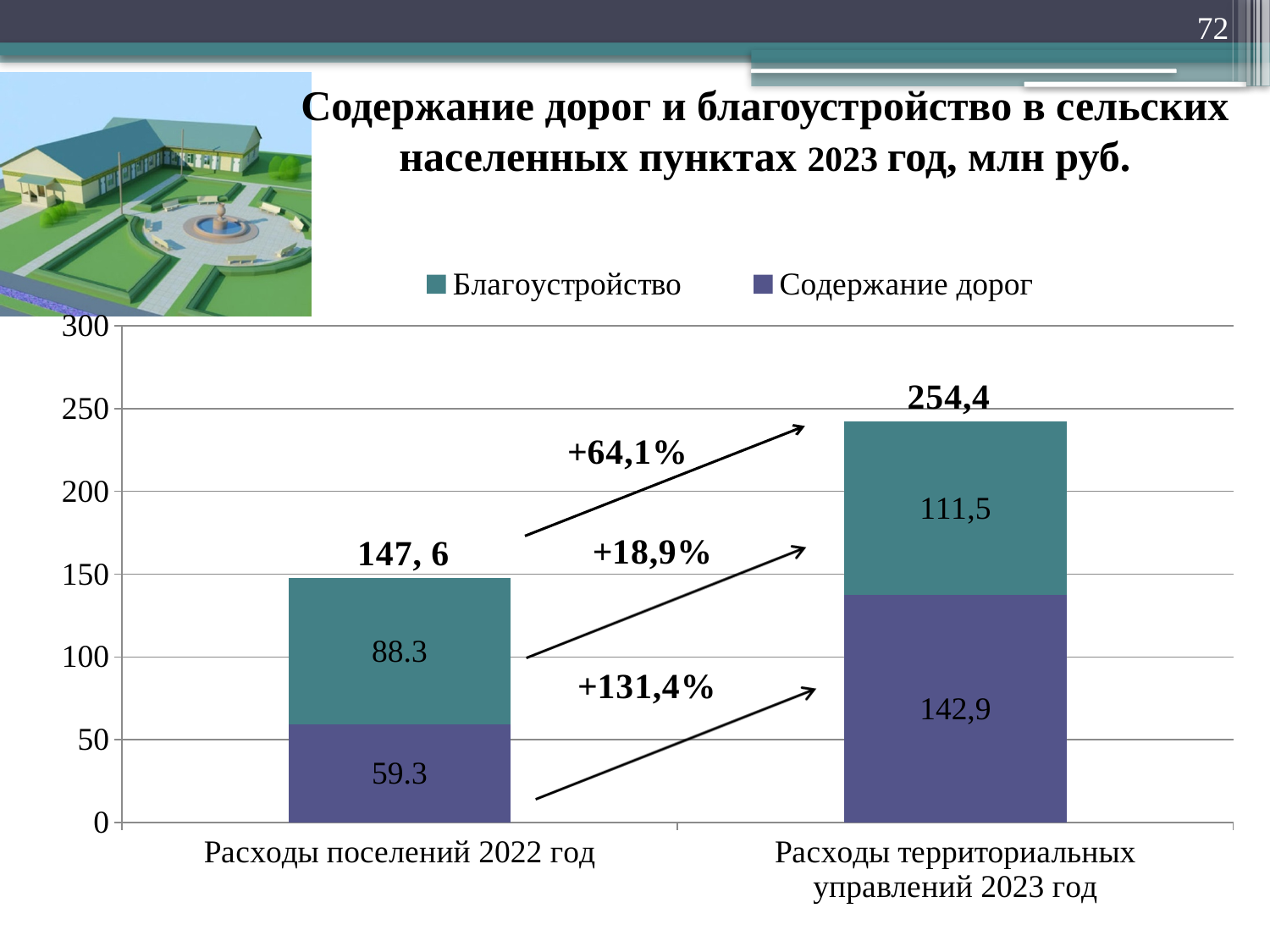
What is the value of Благоустройство for Расходы территориальных управлений 2023 год? 111,5 How many categories are shown on the x axis? 2 Which is larger for Расходы территориальных управлений 2023 год: Содержание дорог or Благоустройство? Содержание дорог What is the total of the stacked bar for Расходы территориальных управлений 2023 год? 254,4 Is the value of Содержание дорог for Расходы территориальных управлений 2023 год greater or less than 100? greater What type of chart is shown on the slide? stacked bar chart Which category has the higher total stacked bar? Расходы территориальных управлений 2023 год What is the difference between Содержание дорог and Благоустройство for Расходы территориальных управлений 2023 год? 31,4 How many series does the legend list? 2 What is the value of Содержание дорог for Расходы поселений 2022 год? 59.3 What is the value of Благоустройство for Расходы поселений 2022 год? 88.3 What is the value of Содержание дорог for Расходы территориальных управлений 2023 год? 142,9